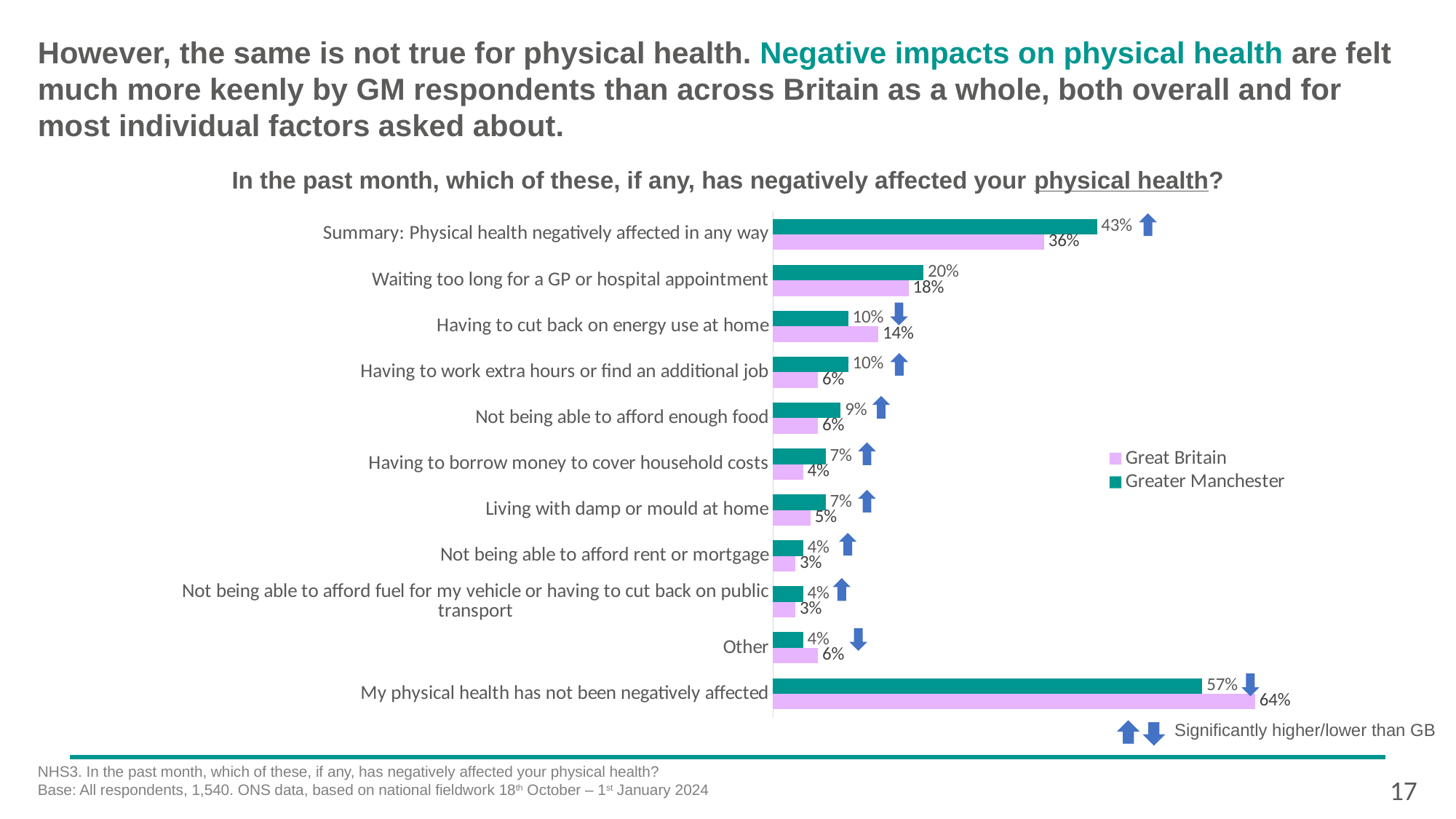
What is the Great Britain value for 'My physical health has not been negatively affected'? 64% How many categories are shown on the chart? 11 What is the Great Britain value for 'Having to cut back on energy use at home'? 14% What is the difference between the Greater Manchester and Great Britain values for 'Summary: Physical health negatively affected in any way'? 7 percentage points What is the Greater Manchester value for 'Waiting too long for a GP or hospital appointment'? 20% For 'Other', which is larger: the Greater Manchester value or the Great Britain value? Great Britain Which category has the highest Greater Manchester value? My physical health has not been negatively affected What type of chart is shown on the slide? Bar chart How many series does the legend list? 2 Which category has the lowest Great Britain value? Not being able to afford rent or mortgage (3%) and Not being able to afford fuel for my vehicle or having to cut back on public transport (3%) What is the Greater Manchester value for 'Summary: Physical health negatively affected in any way'? 43% For 'Having to work extra hours or find an additional job', which is larger: the Greater Manchester value or the Great Britain value? Greater Manchester